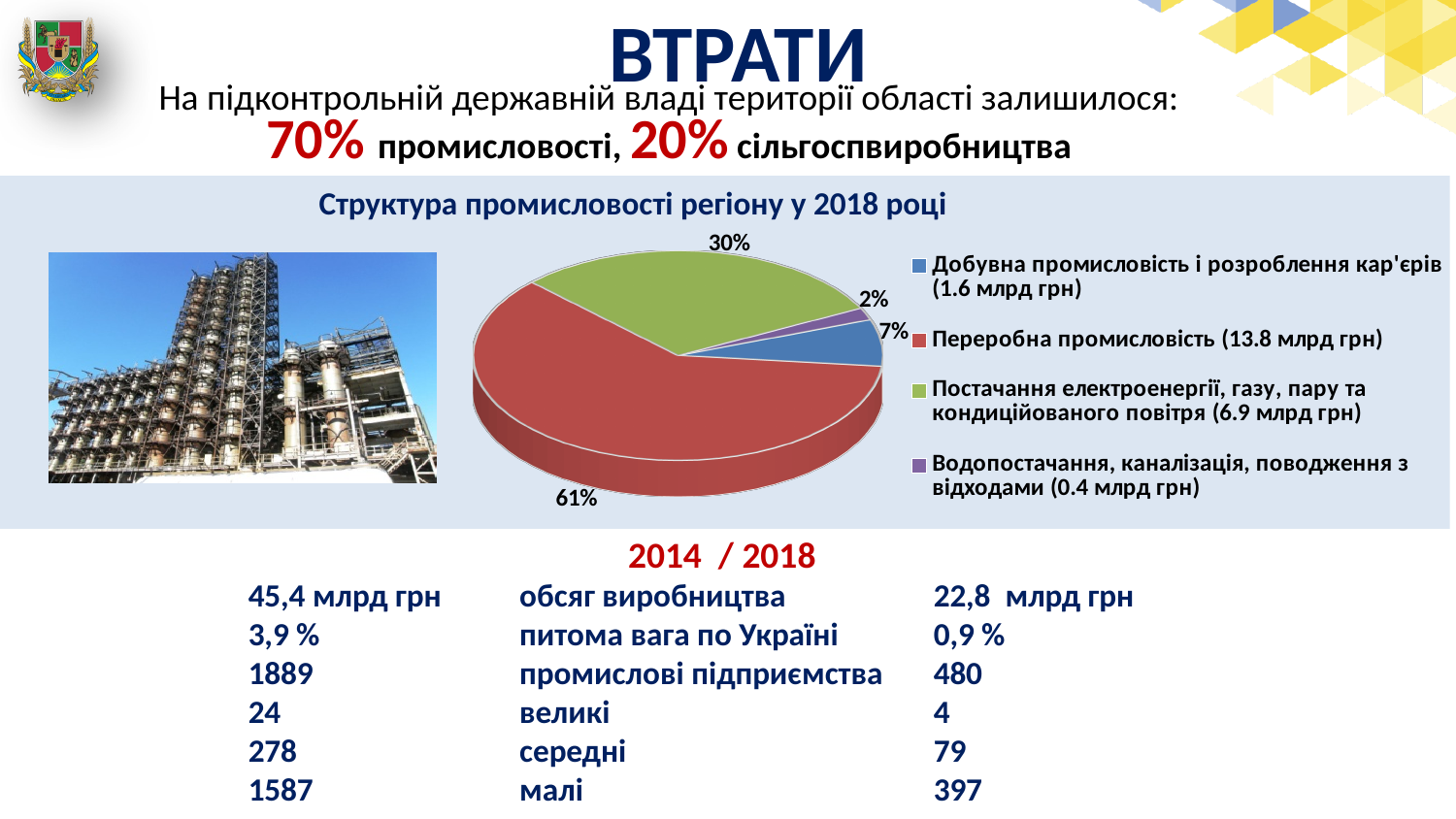
Which category has the smallest slice of the pie? Водопостачання, каналізація, поводження з відходами Which slice is larger: Добувна промисловість or Водопостачання? Добувна промисловість What share of the pie does Переробна промисловість have? 61% Which category has the largest slice of the pie? Переробна промисловість What is the title of the pie chart? Структура промисловості регіону у 2018 році What is the difference in percentage points between the Переробна промисловість slice and the Постачання електроенергії slice? 31 What share of the pie does Добувна промисловість і розроблення кар'єрів have? 7% According to the legend, what value in млрд грн is given for Переробна промисловість? 13.8 млрд грн How many slices does the pie chart have? 4 What kind of chart is shown on the slide? pie chart What share of the pie does Водопостачання, каналізація, поводження з відходами have? 2%